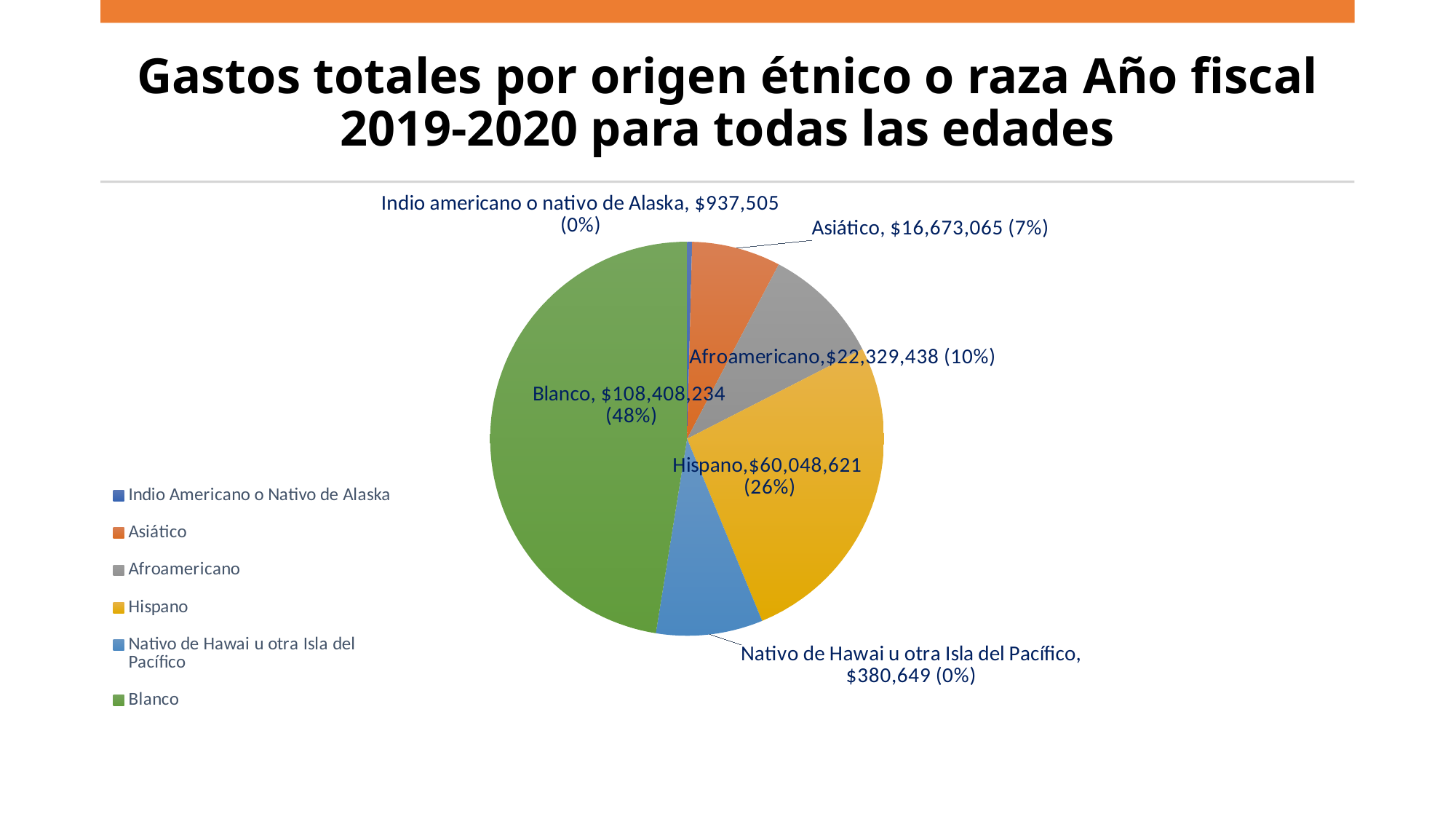
Which has higher spending, Afroamericano or Asiático? Afroamericano What percentage share of the pie does Afroamericano represent? 10% What type of chart is shown on the slide? Pie chart How many categories does the pie chart have? 6 What is the total spending for Blanco? $108,408,234 What is the difference in spending between Blanco and Hispano? $48,359,613 Which category has the largest share of the pie? Blanco What is the total spending for Afroamericano? $22,329,438 What is the total spending for Hispano? $60,048,621 What is the total spending for Asiático? $16,673,065 What percentage share of the pie does Hispano represent? 26%